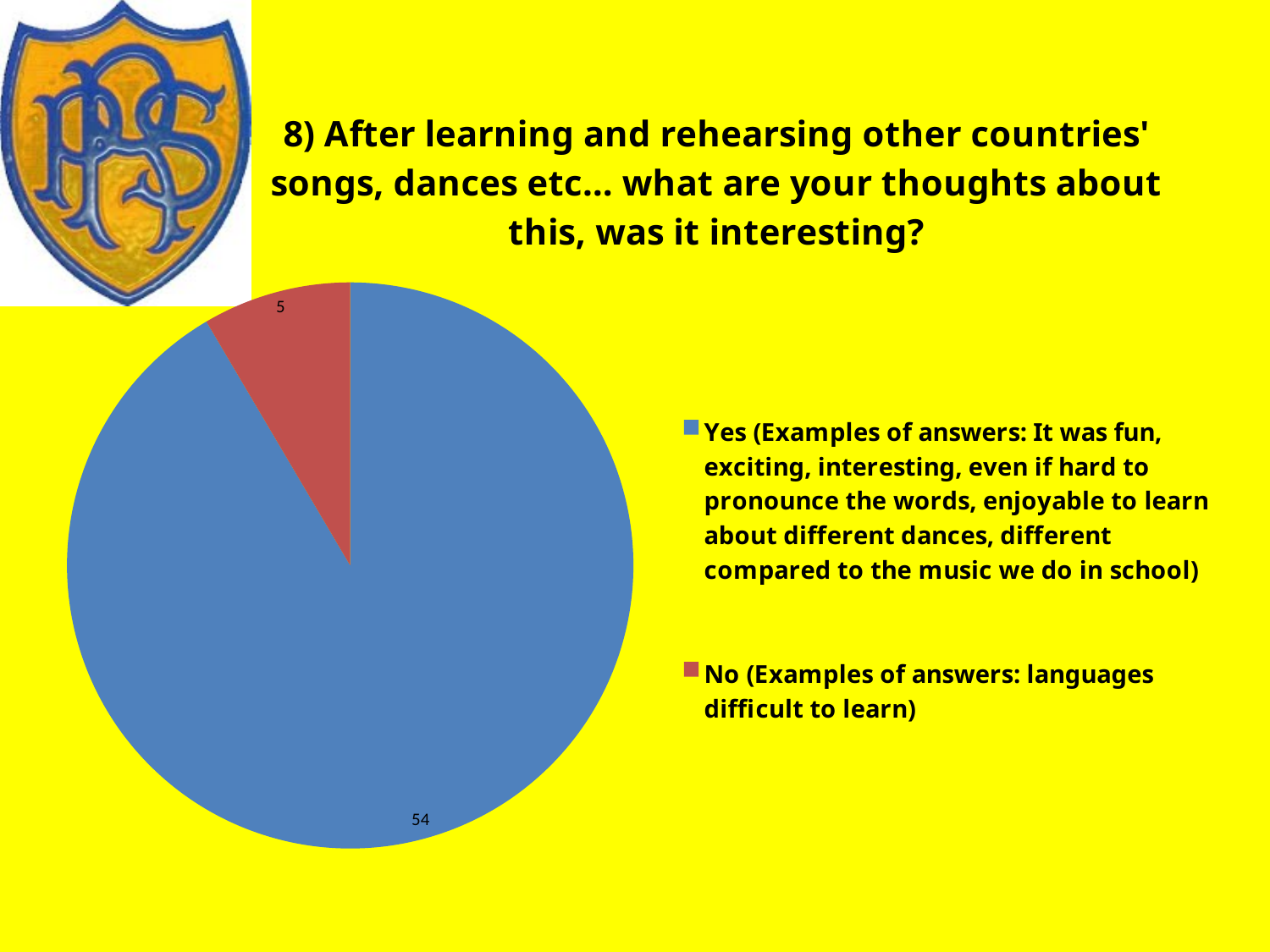
What colour is the 'No' slice? red Which slice is the largest? Yes What is the difference between the 'Yes' and 'No' values? 49 What is the value for the 'No' slice? 5 What colour is the 'Yes' slice? blue Which slice is the smallest? No How many entries does the legend list? 2 What kind of chart is shown on the slide? pie chart What is the value for the 'Yes' slice? 54 Which is larger, the 'Yes' slice or the 'No' slice? Yes What is the total of all slices in the pie chart? 59 How many slices does the pie chart have? 2